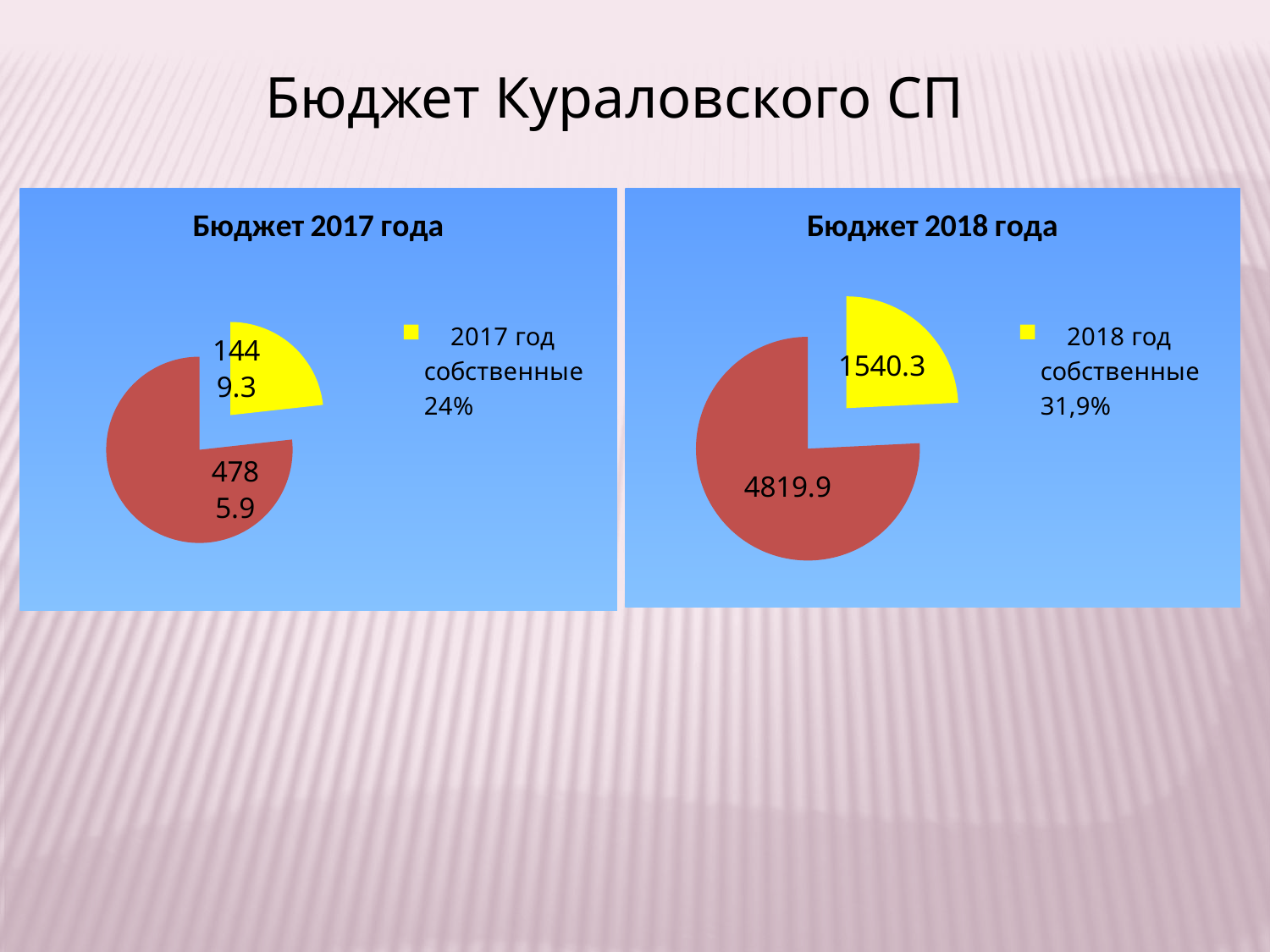
In the chart titled 'Бюджет 2017 года', what value is shown on the red slice? 4785.9 How many slices does the chart titled 'Бюджет 2017 года' have? 2 In the chart titled 'Бюджет 2018 года', what share of the budget do own revenues (собственные) make up according to the legend? 31,9% In the chart titled 'Бюджет 2018 года', what value is shown on the yellow slice (2018 год собственные)? 1540.3 Which is larger: the own revenues (собственные) value in the 2017 budget chart or in the 2018 budget chart? 2018 By how much does the own revenues value in the 'Бюджет 2018 года' chart exceed the own revenues value in the 'Бюджет 2017 года' chart? 91 In the chart titled 'Бюджет 2018 года', what is the total of the two slice values? 6360.2 What kind of chart is used on the slide for the 2017 and 2018 budgets? Pie chart In the chart titled 'Бюджет 2017 года', what value is shown on the yellow slice (2017 год собственные)? 1449.3 In the chart titled 'Бюджет 2018 года', what value is shown on the red slice? 4819.9 In the chart titled 'Бюджет 2017 года', what share of the budget do own revenues (собственные) make up according to the legend? 24% In the chart titled 'Бюджет 2017 года', what is the difference between the red slice value and the yellow slice value? 3336.6